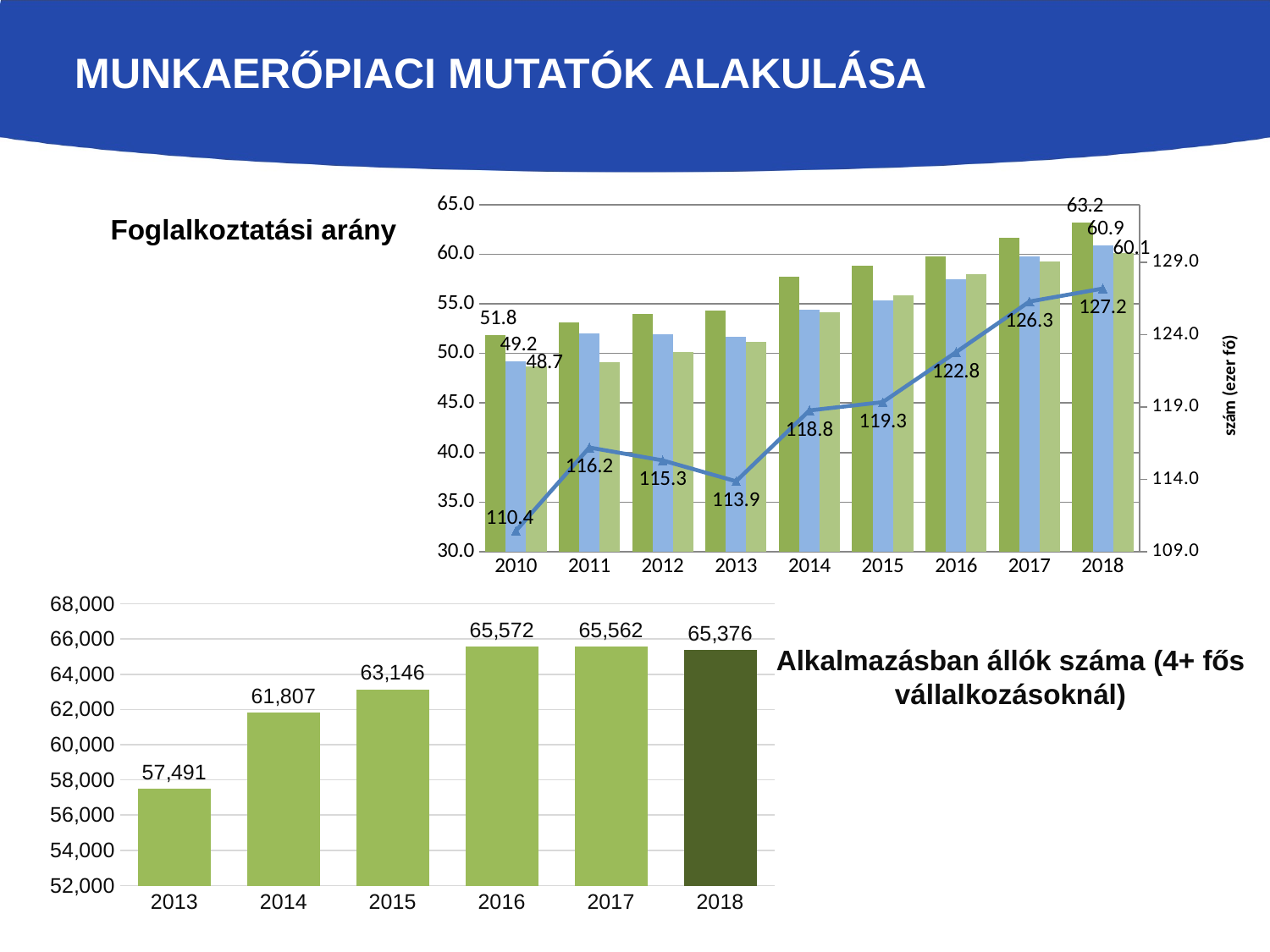
In the top chart (Foglalkoztatási arány), in which year is the line series lowest? 2010 In the top chart (Foglalkoztatási arány), what is the value of the dark green bar for 2018? 63.2 In the top chart (Foglalkoztatási arány), what is the difference between the line series values for 2018 and 2010? 16.8 In the top chart (Foglalkoztatási arány), is the dark green bar for 2014 greater or less than 55.0? greater In the top chart (Foglalkoztatási arány), is the line series value higher in 2017 or 2018? 2018 In the bottom chart (Alkalmazásban állók száma), which year has the lowest value? 2013 In the bottom chart (Alkalmazásban állók száma), what is the value for 2014? 61,807 In the top chart (Foglalkoztatási arány), what is the value of the line series for 2013? 113.9 How many years are shown in the bottom chart (Alkalmazásban állók száma)? 6 In the bottom chart (Alkalmazásban állók száma), which year has the highest value? 2016 What kind of chart is the bottom chart (Alkalmazásban állók száma)? bar chart In the bottom chart (Alkalmazásban állók száma), what is the difference between the 2016 and 2013 values? 8,081